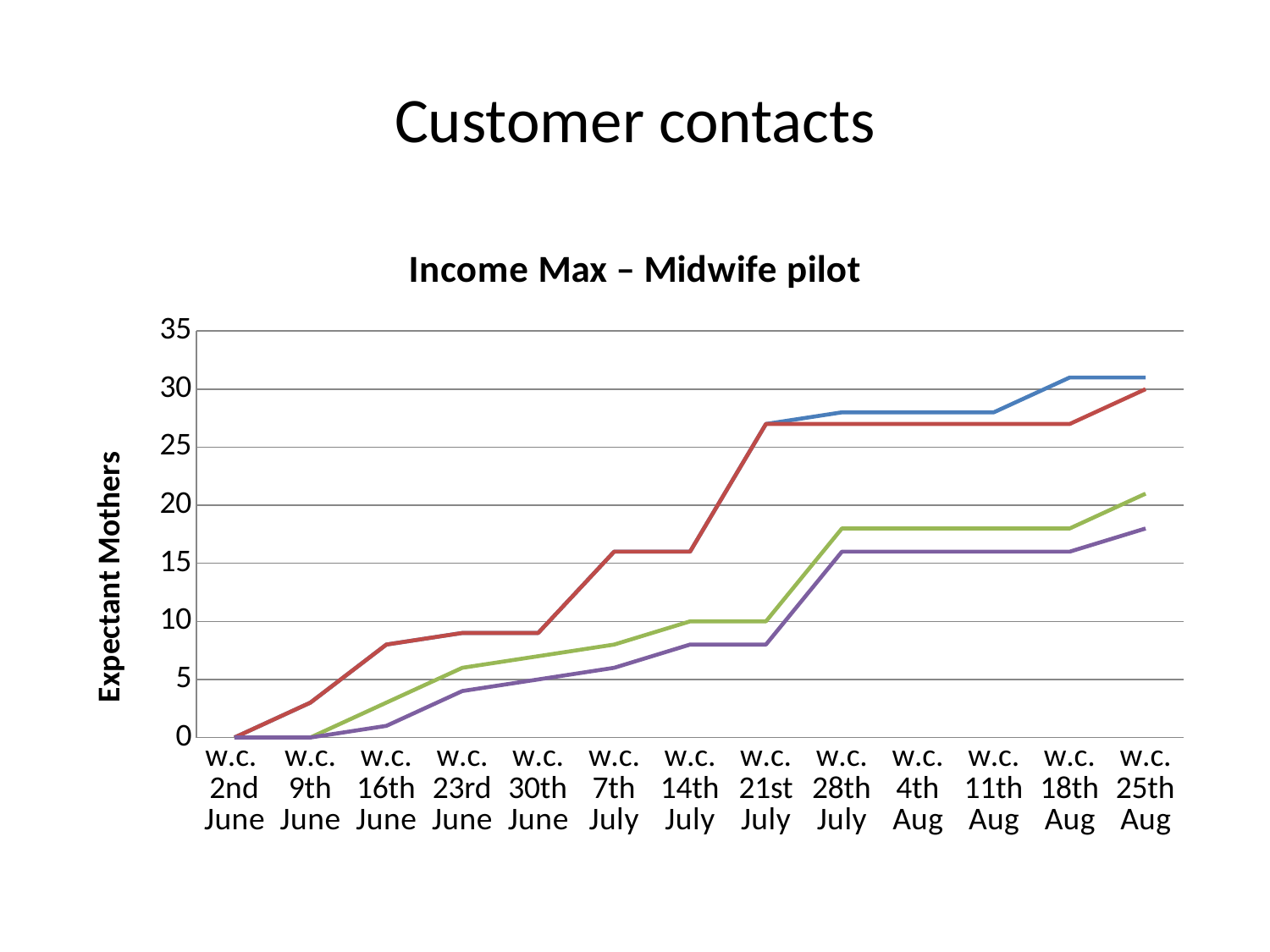
At w.c. 21st July, which line has the larger value, the red line or the green line? red line What kind of chart is shown on the slide? line chart What is the title of the chart? Income Max – Midwife pilot Is the value of the purple line at w.c. 14th July greater or less than 10? less Do the values of the lines generally rise or fall from w.c. 2nd June to w.c. 25th Aug? rise What is the label on the vertical axis of the chart? Expectant Mothers How many lines are plotted on the chart? 4 At which week does the red line reach its highest value? w.c. 25th Aug How many weeks (categories) are shown along the x axis? 13 Is the value of the red line at w.c. 21st July greater or less than 25? greater Is the value of the purple line at w.c. 25th Aug greater or less than 20? less